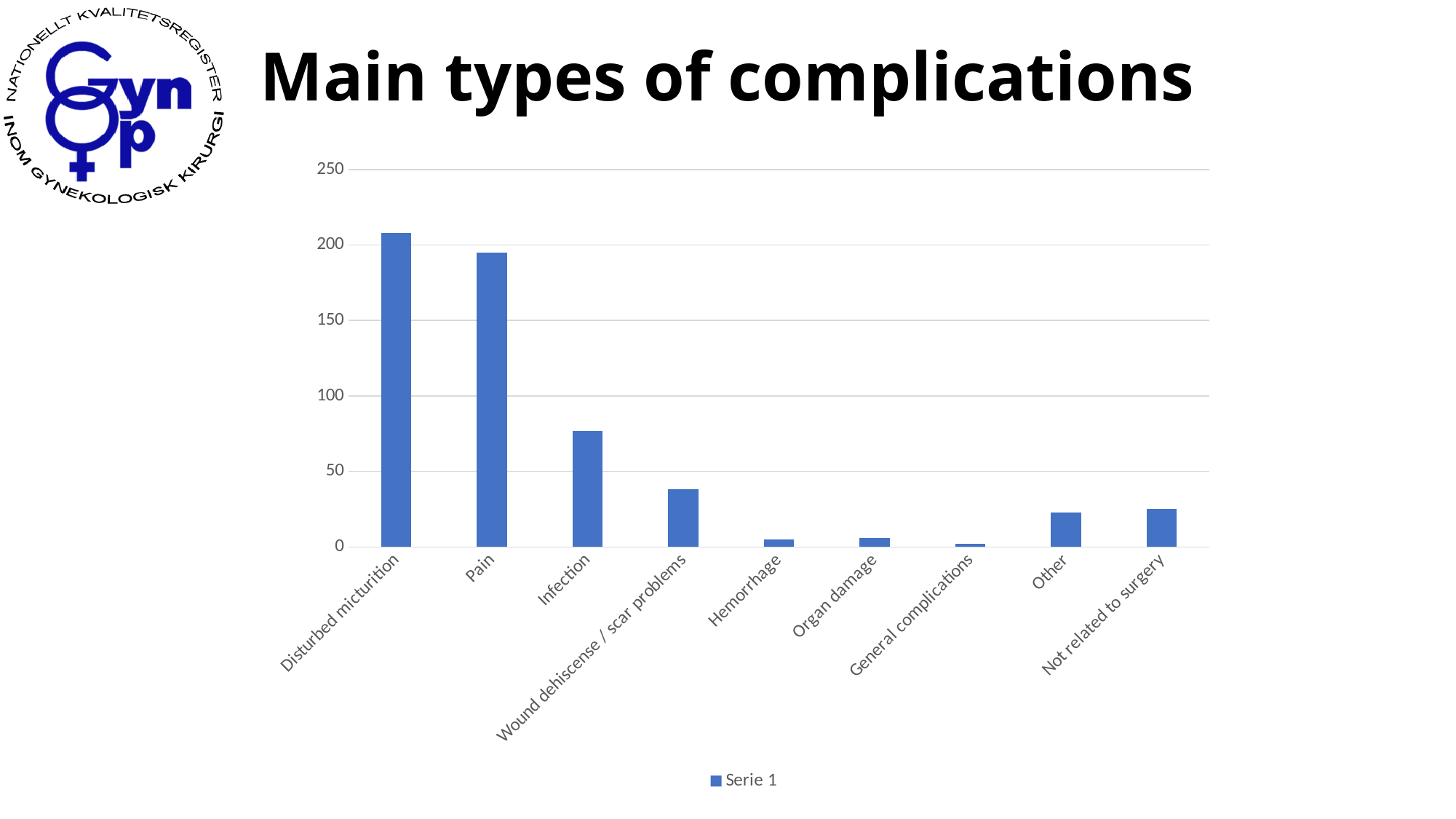
What kind of chart is shown on the slide? bar chart Is the value for Wound dehiscense / scar problems greater or less than 50? less Is the value for Disturbed micturition greater or less than 200? greater Is the value for Infection greater or less than 100? less How many complication categories are shown on the x axis? 9 How many series does the legend list? 1 Which category has the highest value? Disturbed micturition What is the name of the series shown in the legend? Serie 1 Which is larger, the value for Infection or the value for Other? Infection Which category has the lowest value? General complications Which is larger, the value for Hemorrhage or the value for Not related to surgery? Not related to surgery